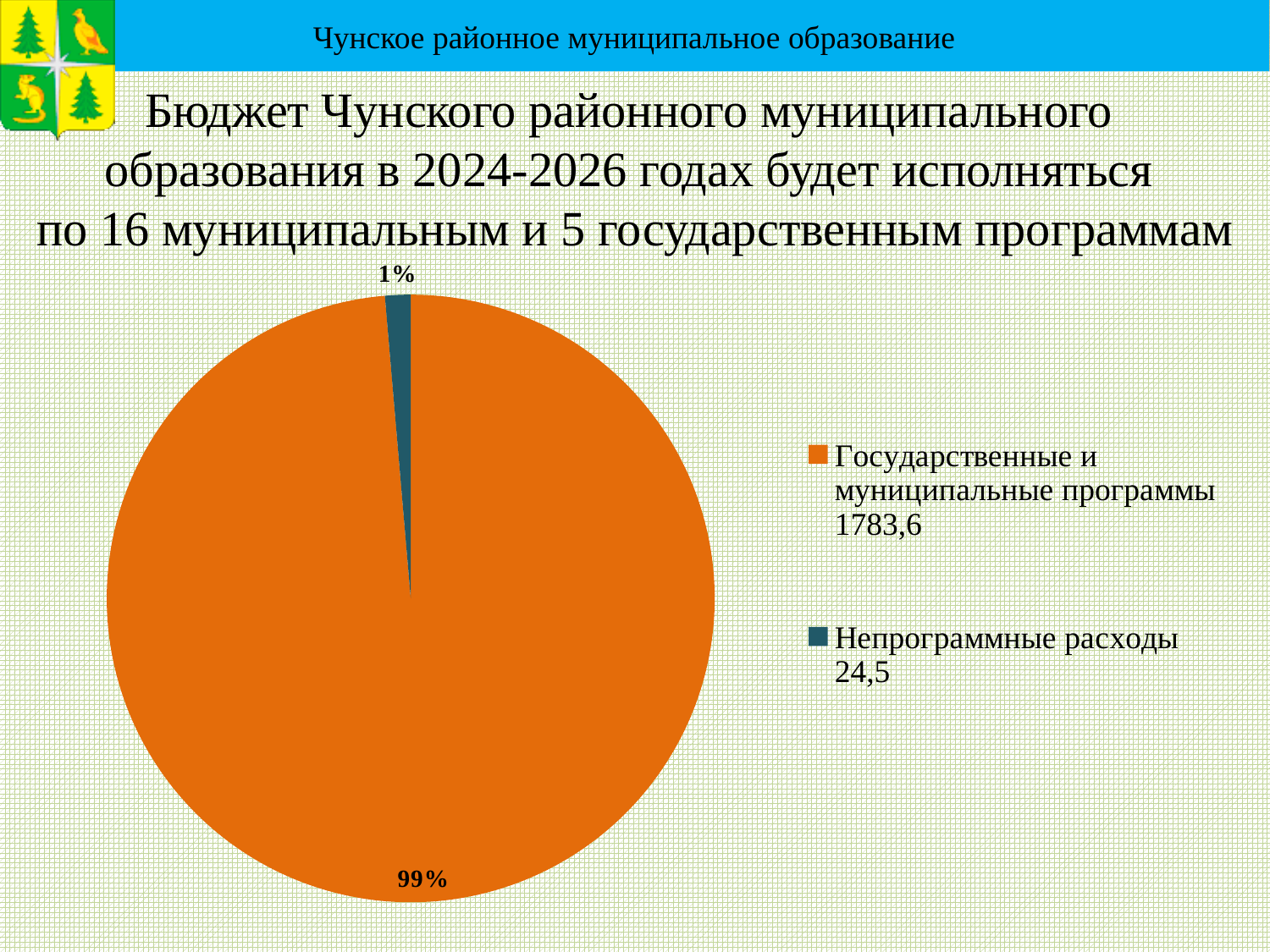
What share of the pie does the slice for Непрограммные расходы represent? 1% What value is shown in the legend for Непрограммные расходы? 24,5 What share of the pie does the slice for Государственные и муниципальные программы represent? 99% Which category has the largest slice of the pie? Государственные и муниципальные программы Which category has the smallest slice of the pie? Непрограммные расходы What is the difference between the values for Государственные и муниципальные программы (1783,6) and Непрограммные расходы (24,5)? 1759,1 How many slices does the pie chart have? 2 What kind of chart is shown on the slide? pie chart Which is larger: Государственные и муниципальные программы or Непрограммные расходы? Государственные и муниципальные программы What colour is the slice for Непрограммные расходы? dark teal What value is shown in the legend for Государственные и муниципальные программы? 1783,6 How many entries does the legend of the pie chart list? 2